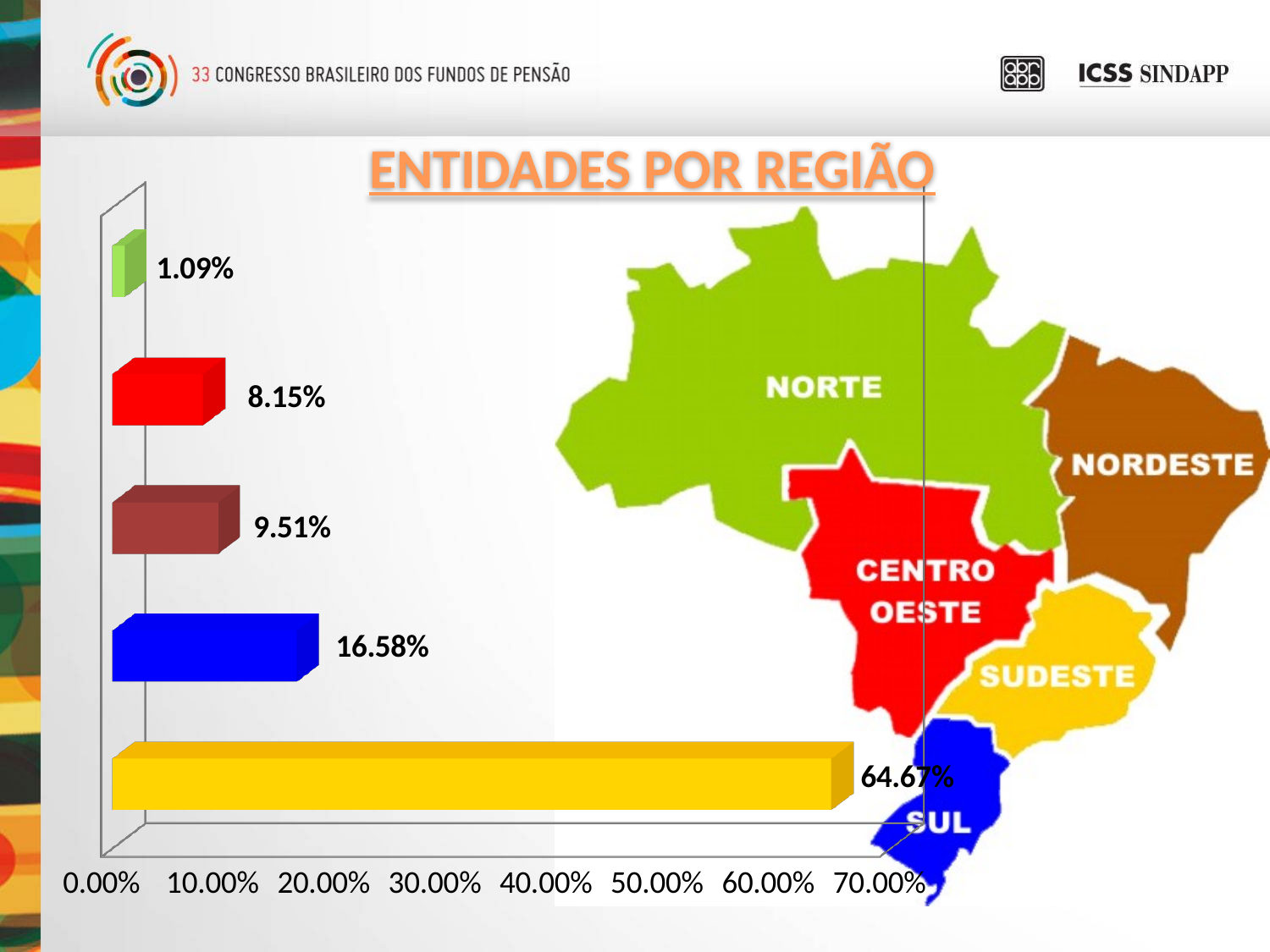
What is the value shown on the green bar? 1.09% Which bar has the lowest value? the green bar (1.09%) What is the value shown on the brown bar? 9.51% What is the value shown on the red bar? 8.15% Which bar has the highest value? the yellow bar (64.67%) What is the value shown on the yellow bar? 64.67% What is the title of the chart on the slide? ENTIDADES POR REGIÃO What type of chart is shown on the slide? bar chart How many bars are plotted in the chart? 5 What is the difference between the yellow bar's value and the blue bar's value? 48.09% What is the value shown on the blue bar? 16.58% Which is larger, the value of the brown bar or the value of the red bar? the brown bar (9.51%)